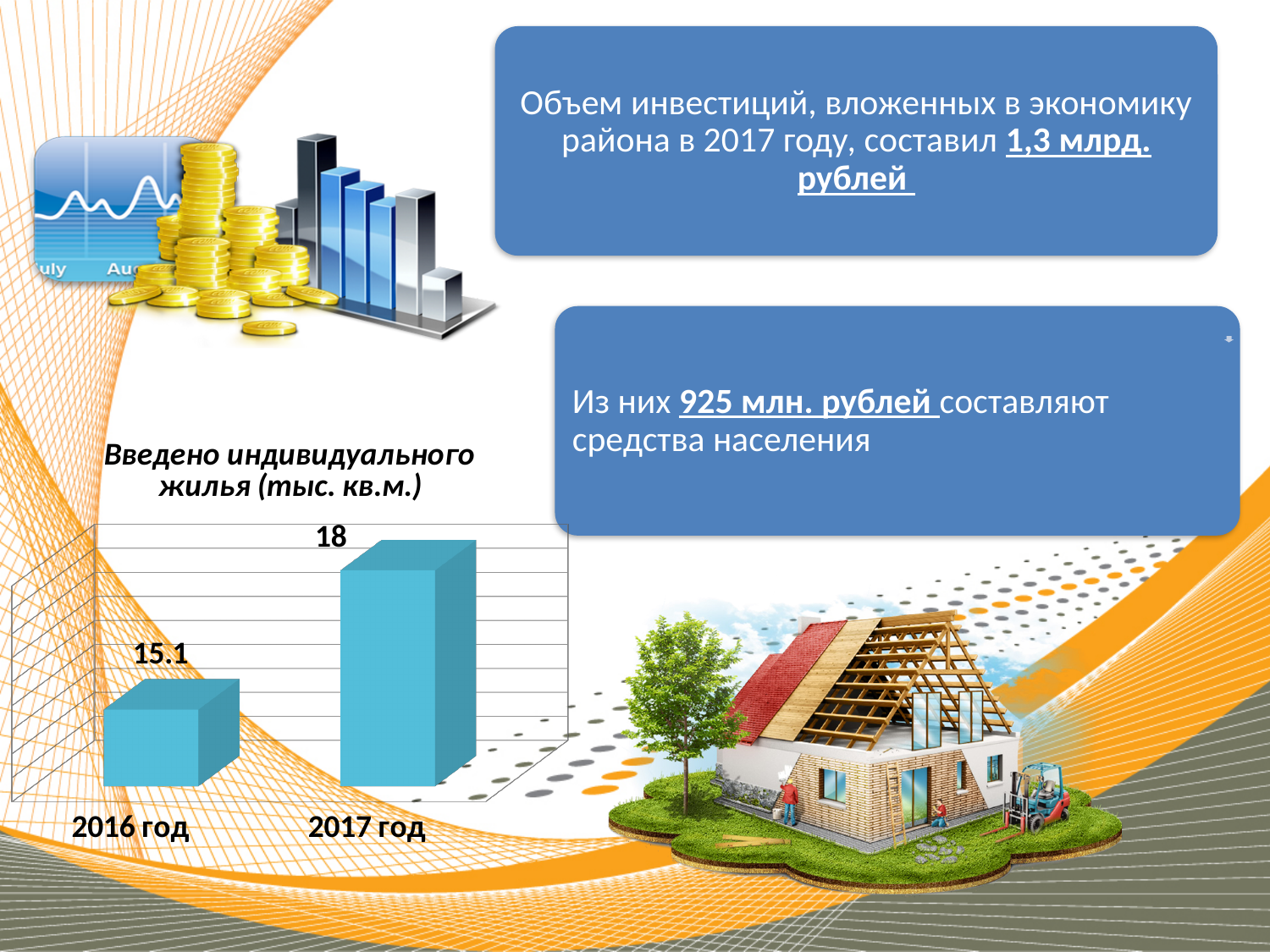
What is the title of the chart? Введено индивидуального жилья (тыс. кв.м.) How many categories are shown in the chart? 2 Which year has the highest value in the chart? 2017 год What is the difference between the values for 2017 год and 2016 год? 2.9 What is the value for 2017 год in the chart? 18 What is the value for 2016 год in the chart? 15.1 What kind of chart is shown on the slide? Bar chart Which year has the lowest value in the chart? 2016 год Which is larger, the value for 2016 год or for 2017 год? 2017 год Do the values rise or fall from 2016 год to 2017 год? Rise What unit is given in the chart title? тыс. кв.м.